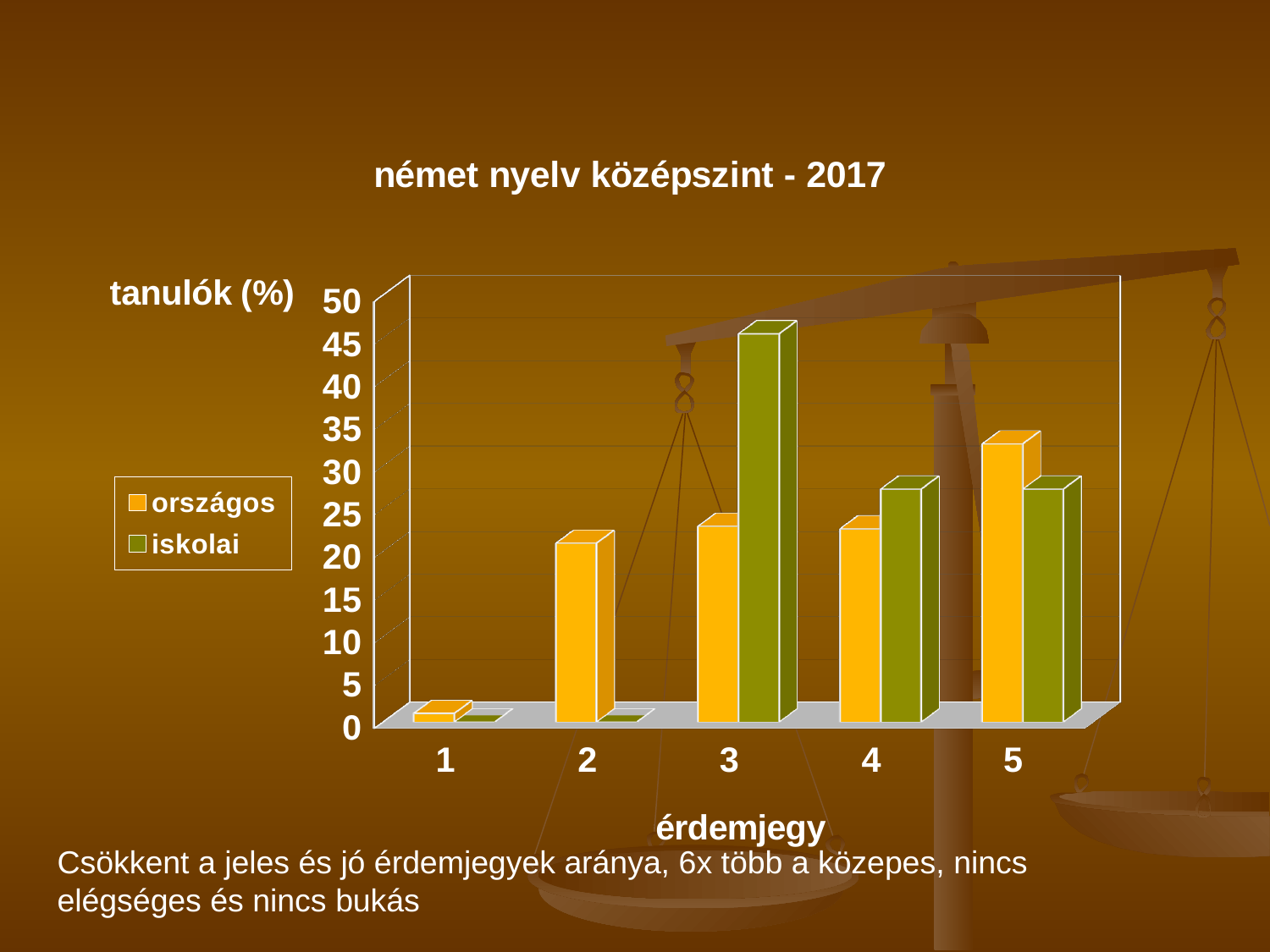
For which érdemjegy is the iskolai value highest? 3 Which two series are listed in the legend? országos and iskolai For which érdemjegy is the országos value highest? 5 What kind of chart is shown on the slide? bar chart How many series does the legend list? 2 Is the iskolai value for érdemjegy 3 greater or less than 40? greater For which érdemjegy is the országos value lowest? 1 How many categories (érdemjegy values) are shown on the x axis? 5 Is the országos value for érdemjegy 1 greater or less than 5? less For érdemjegy 3, which series has the larger value, országos or iskolai? iskolai Is the országos value for érdemjegy 5 greater or less than 30? greater What is the title of the chart? német nyelv középszint - 2017